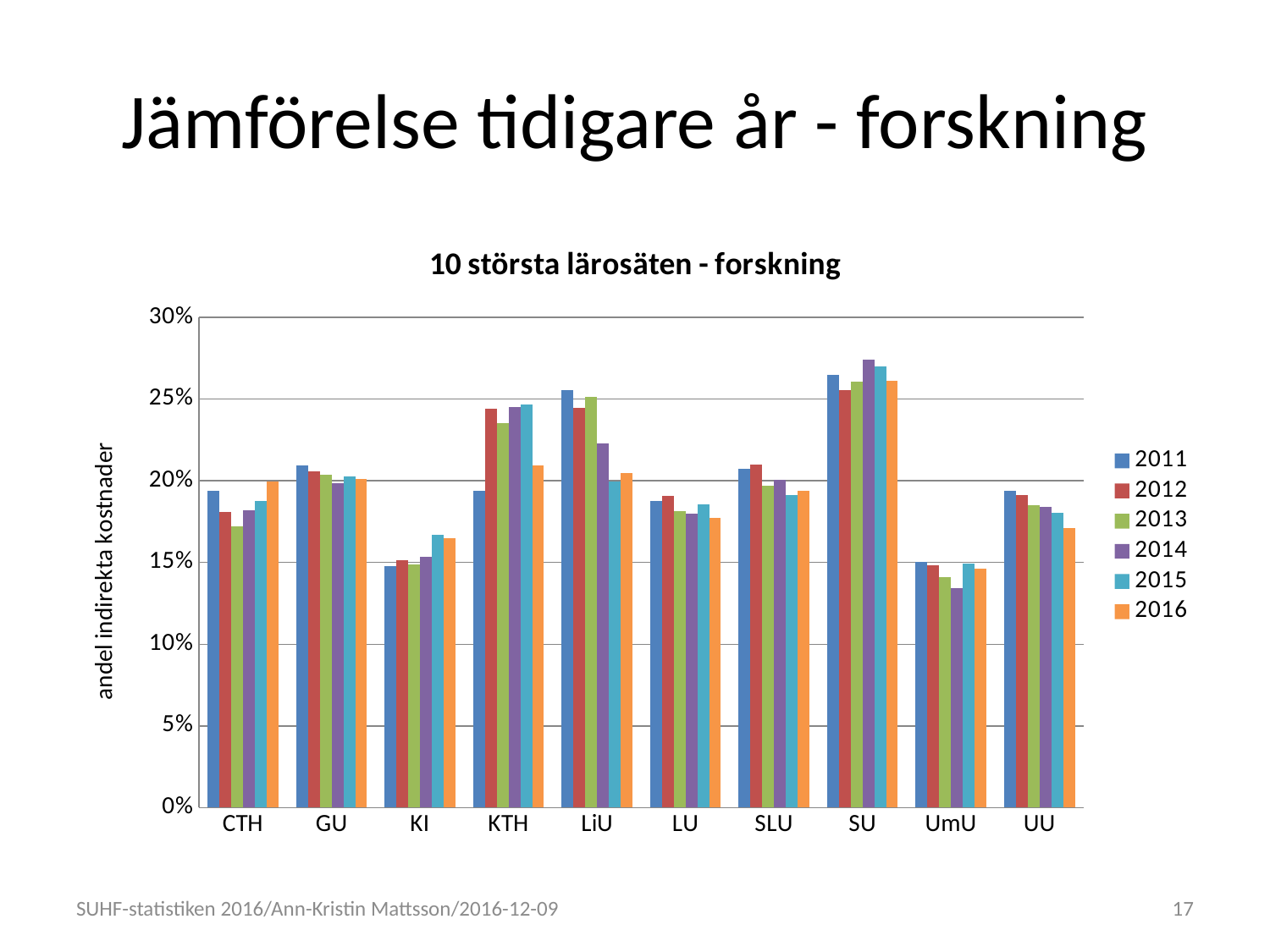
How many series does the legend list? 6 Which institution has the lowest value for 2016? UmU What kind of chart is shown on the slide? bar chart Do the values for UU rise or fall from 2011 to 2016? fall How many institutions (categories) are shown on the x axis? 10 Is the value for SU in 2014 greater or less than 25%? greater Which institution has the highest value for 2016? SU What is the title of the chart? 10 största lärosäten - forskning Is the value for UmU in 2014 greater or less than 15%? less Which is larger: the 2011 value for KTH or the 2012 value for KTH? 2012 Which is larger: the 2011 value for LiU or the 2015 value for LiU? 2011 Is the value for CTH in 2013 greater or less than 20%? less